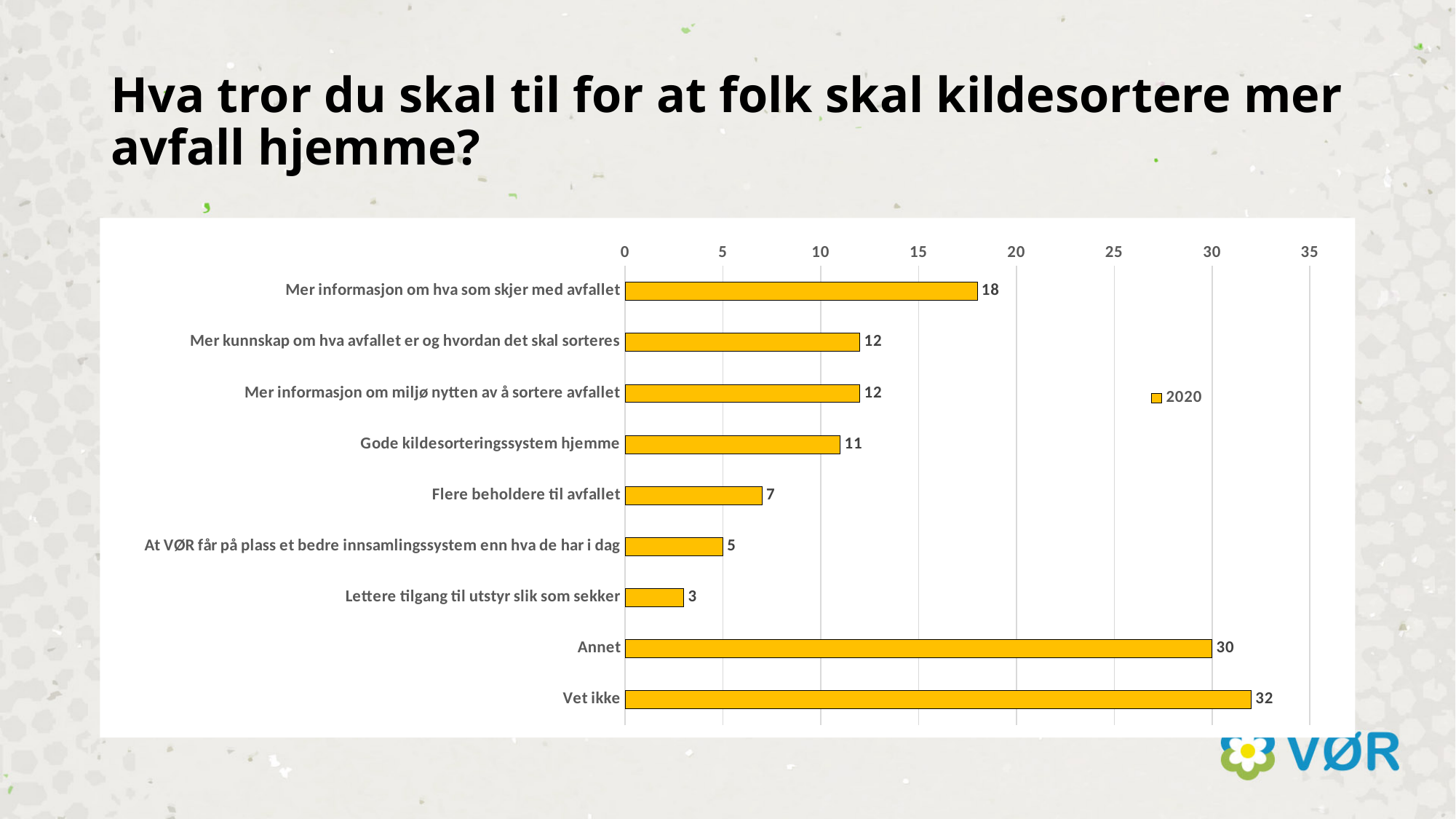
What is the value for "Lettere tilgang til utstyr slik som sekker"? 3 What kind of chart is shown on the slide? Bar chart What series name is shown in the legend? 2020 How many series does the legend list? 1 Which category has the lowest value? Lettere tilgang til utstyr slik som sekker What is the value for "Mer informasjon om hva som skjer med avfallet"? 18 How many categories are shown in the chart? 9 What is the difference between the values for "Annet" and "Gode kildesorteringssystem hjemme"? 19 What is the value for "Flere beholdere til avfallet"? 7 Which is larger, the value for "Mer informasjon om hva som skjer med avfallet" or the value for "Annet"? Annet Which category has the highest value? Vet ikke What is the value for "Vet ikke"? 32